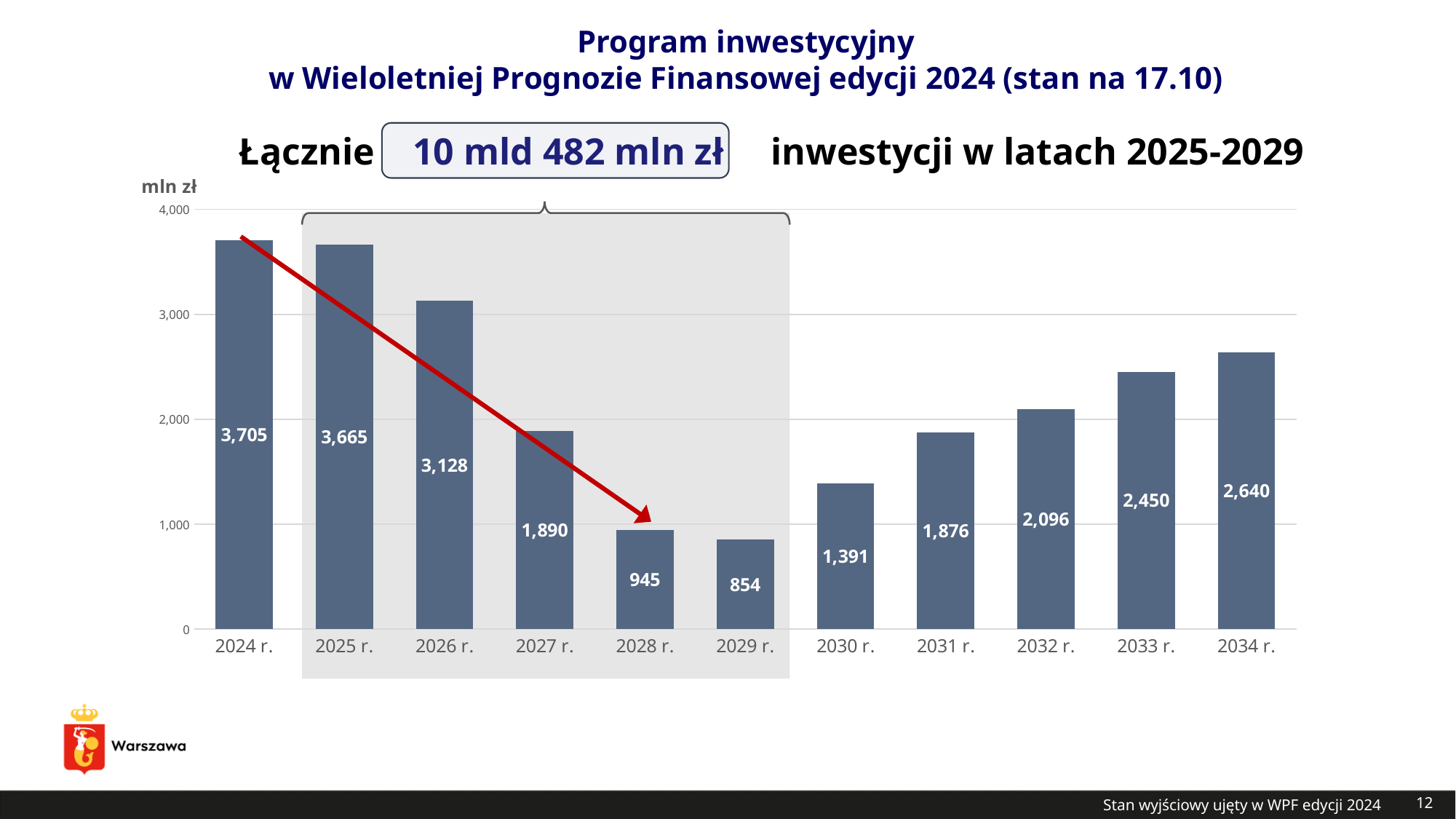
Is the value for 2032 r. greater or less than 2,000? greater Do the values rise or fall from 2024 r. to 2029 r.? fall What is the difference between the values for 2034 r. and 2033 r.? 190 What is the value for 2026 r.? 3,128 Which year has the highest value? 2024 r. Which year has the lowest value? 2029 r. What is the difference between the values for 2024 r. and 2025 r.? 40 How many years are shown on the x axis? 11 What kind of chart is shown on the slide? bar chart What is the value for 2031 r.? 1,876 Which is larger, the value for 2027 r. or the value for 2031 r.? 2027 r. What is the value for 2029 r.? 854